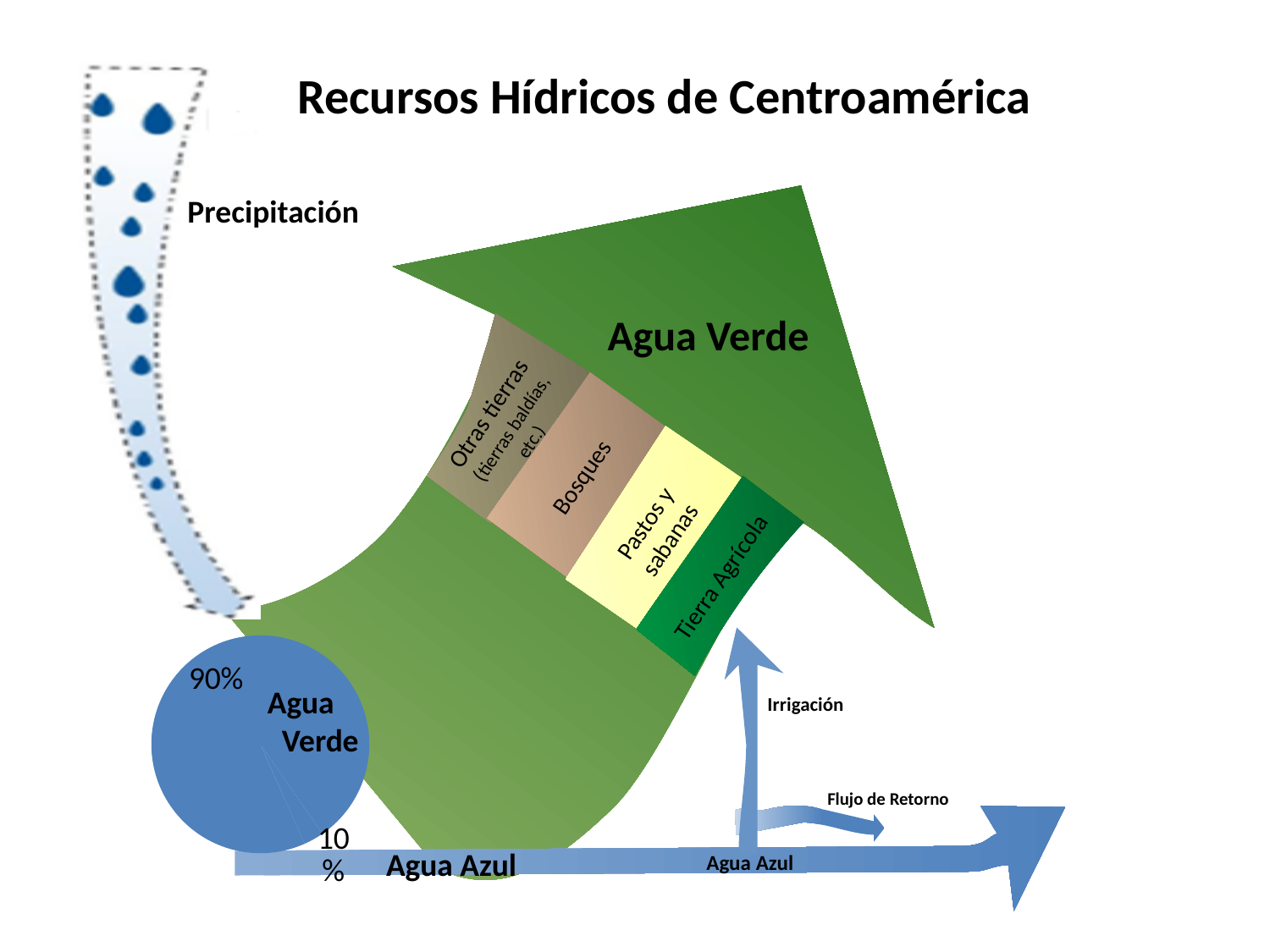
In the pie chart, what share is labelled for Agua Verde? 90% Is the share for Agua Verde in the pie chart greater or less than 50%? greater How many slices does the pie chart have? 2 What is the title of the slide containing the pie chart? Recursos Hídricos de Centroamérica What colour is the pie chart drawn in? blue In the pie chart, what share is shown for the smaller slice? 10% In the pie chart, is the Agua Verde slice larger or smaller than the other slice? larger By how many percentage points does the Agua Verde slice exceed the smaller slice in the pie chart? 80 percentage points What kind of chart is shown in the lower left of the slide? pie chart Which slice of the pie chart is the largest? Agua Verde